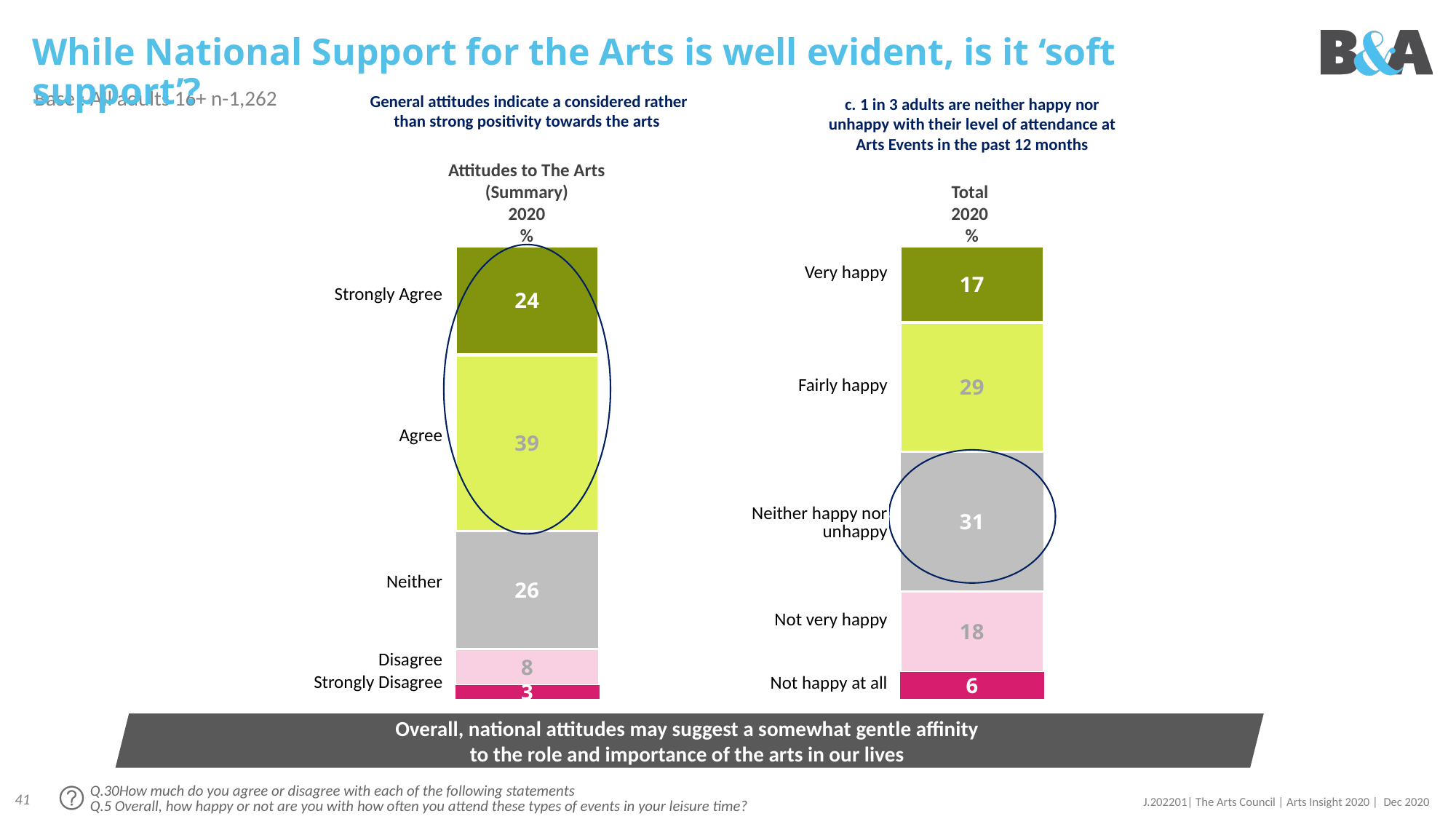
In the 'Attitudes to The Arts (Summary)' chart on the left, how many categories are shown in the stacked bar? 5 In the 'Attitudes to The Arts (Summary)' chart on the left, what is the value for Agree? 39 In the 'Total 2020 %' chart on the right, what is the value for Neither happy nor unhappy? 31 In the 'Attitudes to The Arts (Summary)' chart on the left, what is the difference between Strongly Agree and Neither? 2 In the 'Total 2020 %' chart on the right, what is the difference between Fairly happy and Very happy? 12 In the 'Total 2020 %' chart on the right, which is larger: Very happy or Fairly happy? Fairly happy In the 'Total 2020 %' chart on the right, what is the total of all segments in the stacked bar? 101 In the 'Attitudes to The Arts (Summary)' chart on the left, what is the value for Strongly Disagree? 3 In the 'Total 2020 %' chart on the right, what is the value for Not very happy? 18 In the 'Total 2020 %' chart on the right, which category has the lowest value? Not happy at all In the 'Attitudes to The Arts (Summary)' chart on the left, which category has the highest value? Agree What kind of chart is used on the right side of the slide for 'Total 2020 %'? Stacked bar chart